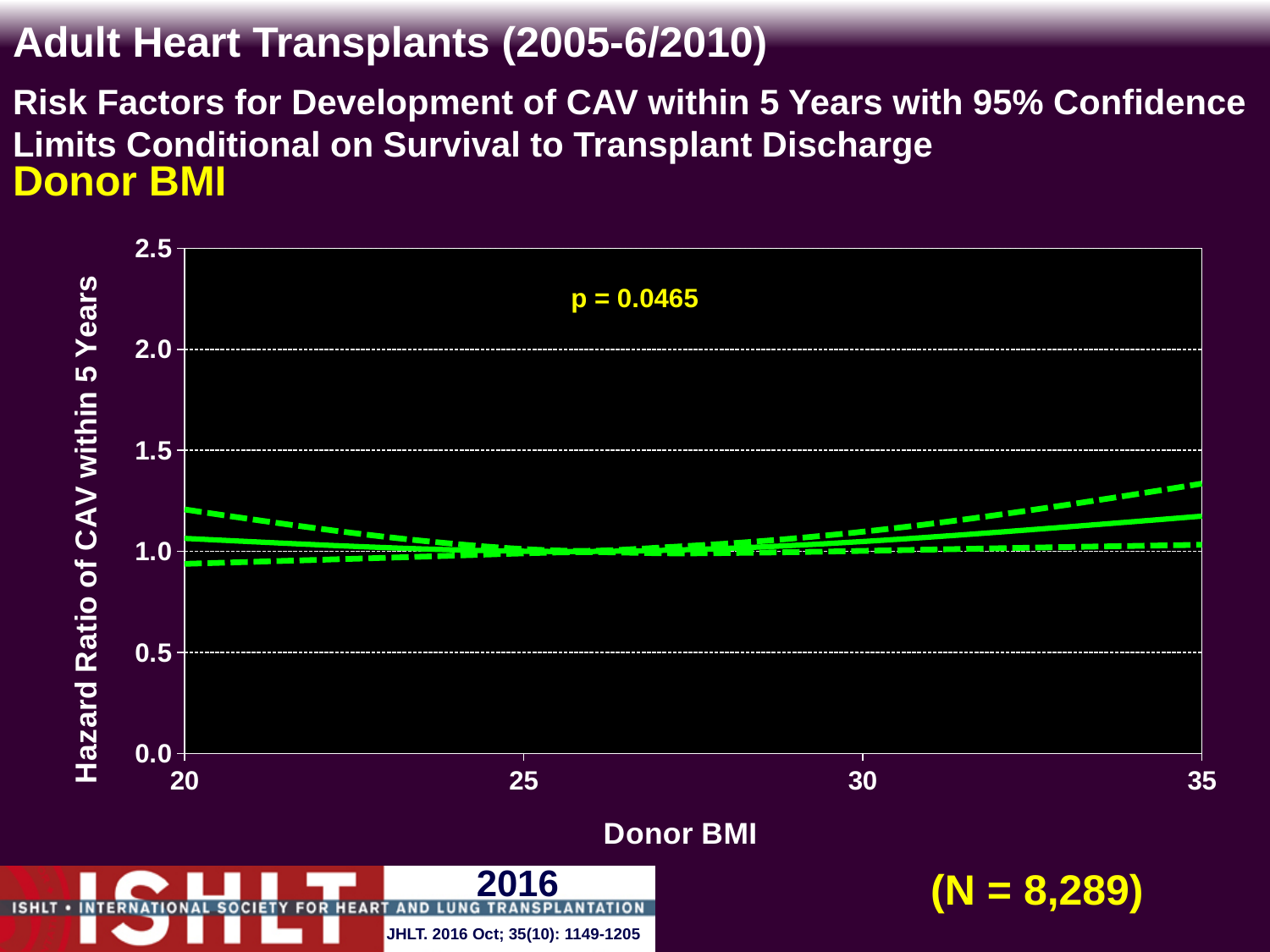
Is the lower 95% confidence limit at a donor BMI of 20 greater or less than 1.0? less Is the hazard ratio (solid line) at a donor BMI of 35 greater or less than 1.5? less Is the hazard ratio (solid line) at a donor BMI of 35 greater or less than 1.0? greater What is the label of the y axis? Hazard Ratio of CAV within 5 Years What kind of chart is shown on the slide? line chart What is the highest value shown on the y axis? 2.5 What sample size (N) is shown on the slide? N = 8,289 What is the label of the x axis? Donor BMI What p-value is printed on the chart? p = 0.0465 Does the hazard ratio (solid line) rise or fall as donor BMI increases from 25 to 35? rise